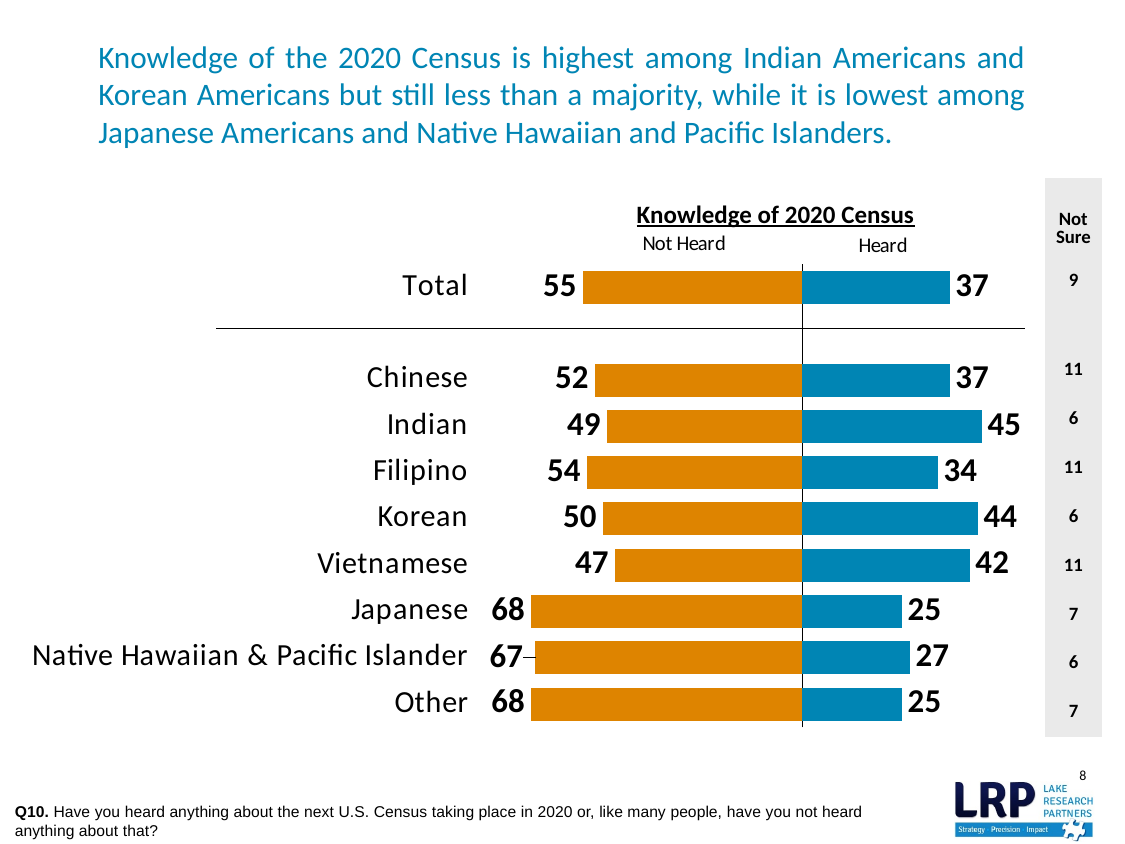
How many groups are shown in the chart, including Total? 9 What percentage of Indian respondents have heard about the 2020 Census? 45 What is the difference between the Heard values for Korean and Filipino respondents? 10 What kind of chart is shown on the slide? Bar chart Which is larger, the Heard value for Chinese or for Vietnamese respondents? Vietnamese Which group has the highest Heard value? Indian Which group has the lowest Not Heard value? Vietnamese Which colour represents the Heard series? Blue What is the Not Heard value for Japanese respondents? 68 What is the Not Sure value for Native Hawaiian & Pacific Islander respondents? 6 How many series does the chart show (excluding the Not Sure column)? 2 What is the Heard value for the Total row? 37